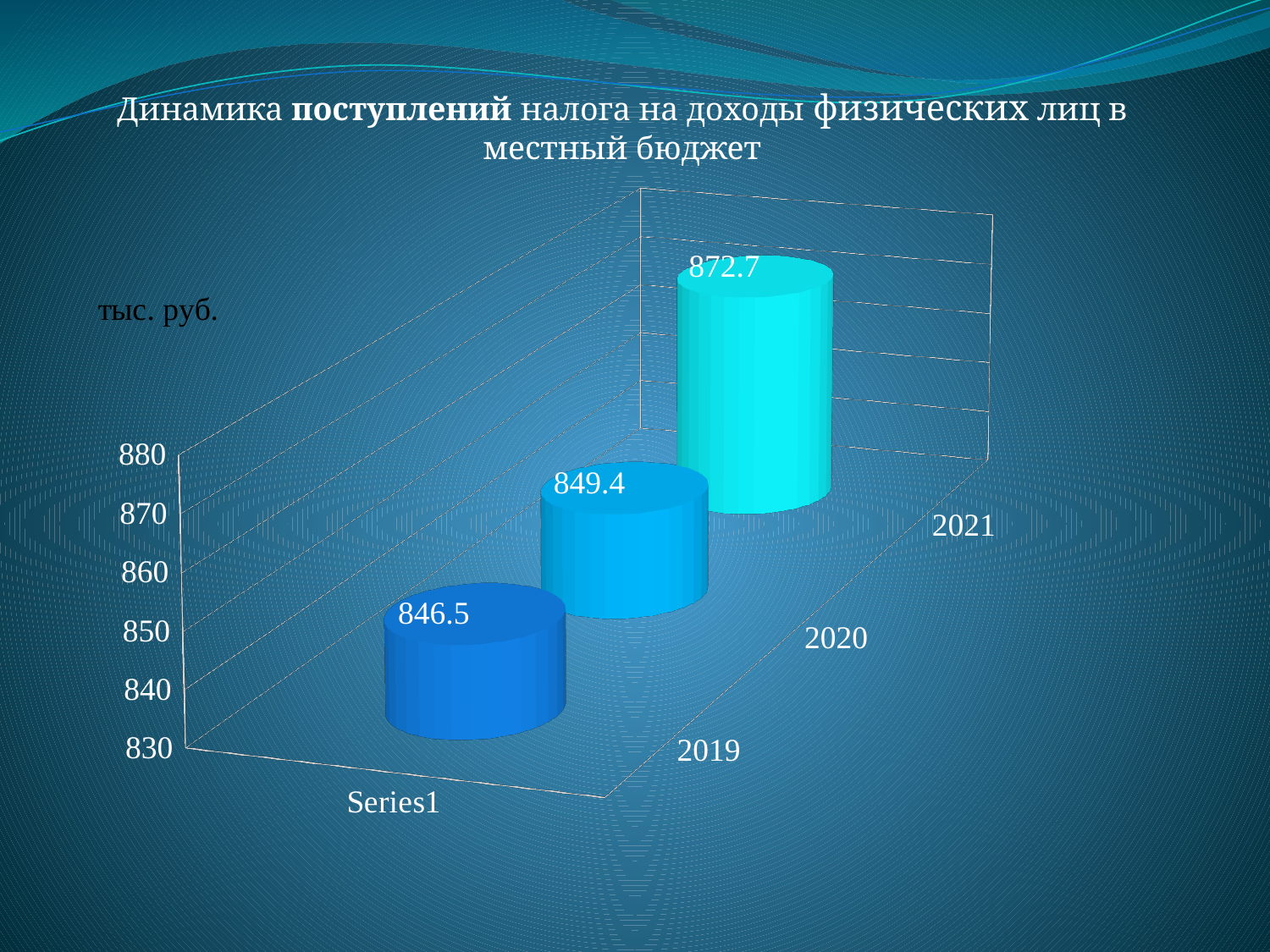
Do the values rise or fall from 2019 to 2021? rise What unit is shown on the chart's axis label? тыс. руб. Which year has the highest value? 2021 Which is larger, the value for 2021 or the value for 2019? 2021 What is the value for 2019? 846.5 Is the value for 2021 greater or less than 860? greater What is the difference between the values for 2020 and 2019? 2.9 What is the difference between the values for 2021 and 2020? 23.3 How many years are shown on the chart? 3 What is the value for 2021? 872.7 Which year has the lowest value? 2019 What is the value for 2020? 849.4